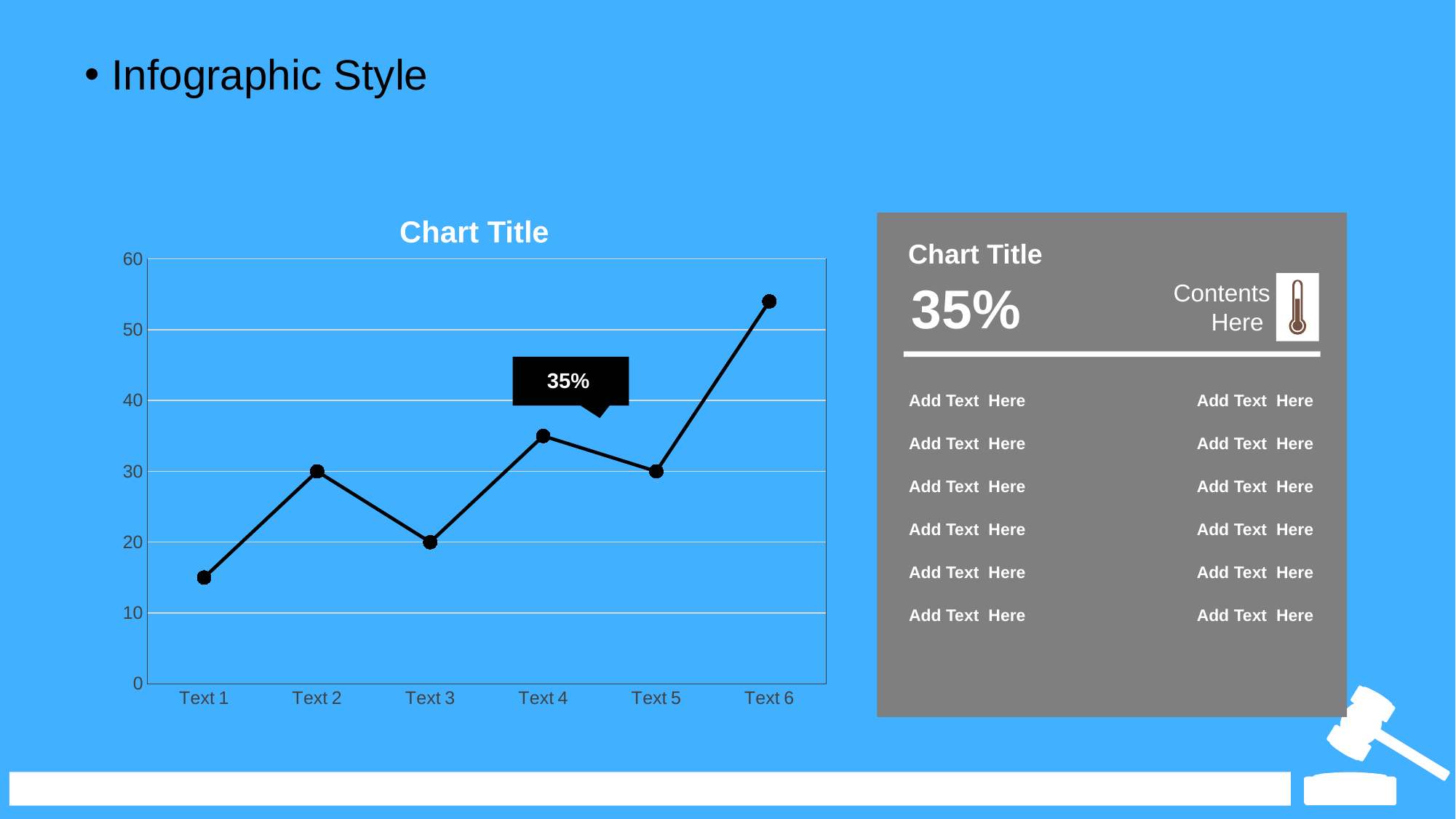
How many categories are plotted along the x axis of the chart? 6 Is the value for Text 1 greater or less than 20? less What is the difference between the values for Text 2 and Text 3? 10 Which category has the highest value on the chart? Text 6 Does the line rise or fall from Text 5 to Text 6? rise What kind of chart is shown on the slide? line chart Which category has the lowest value on the chart? Text 1 What value is labelled on the chart for Text 4? 35% What is the value for Text 2 on the chart? 30 Is the value for Text 6 greater or less than 50? greater Which is larger, the value for Text 2 or the value for Text 3? Text 2 What is the value for Text 3 on the chart? 20